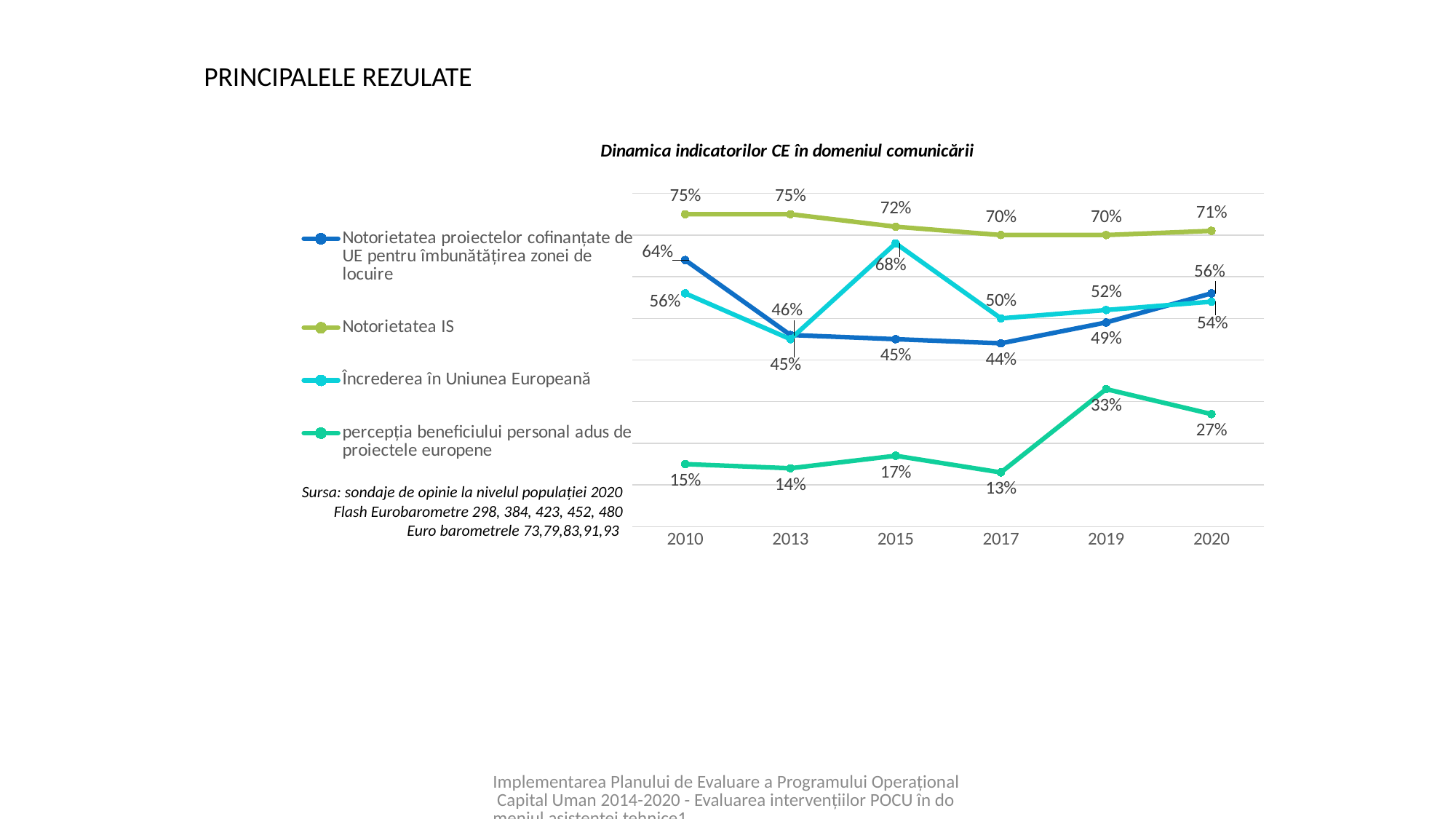
In which year is Încrederea în Uniunea Europeană highest? 2015 What is the value of Notorietatea IS in 2015? 72% Does Notorietatea IS rise or fall from 2010 to 2017? fall What is the difference between the 2010 and 2017 values of Notorietatea proiectelor cofinanțate de UE pentru îmbunătățirea zonei de locuire? 20% What type of chart is shown on the slide? line chart How many series does the legend list? 4 How many years are shown on the x axis? 6 What is the value of percepția beneficiului personal adus de proiectele europene in 2019? 33% In which year is percepția beneficiului personal adus de proiectele europene lowest? 2017 What is the value of Încrederea în Uniunea Europeană in 2017? 50% What is the title of the chart? Dinamica indicatorilor CE în domeniul comunicării Which is larger in 2020: Notorietatea IS or Încrederea în Uniunea Europeană? Notorietatea IS